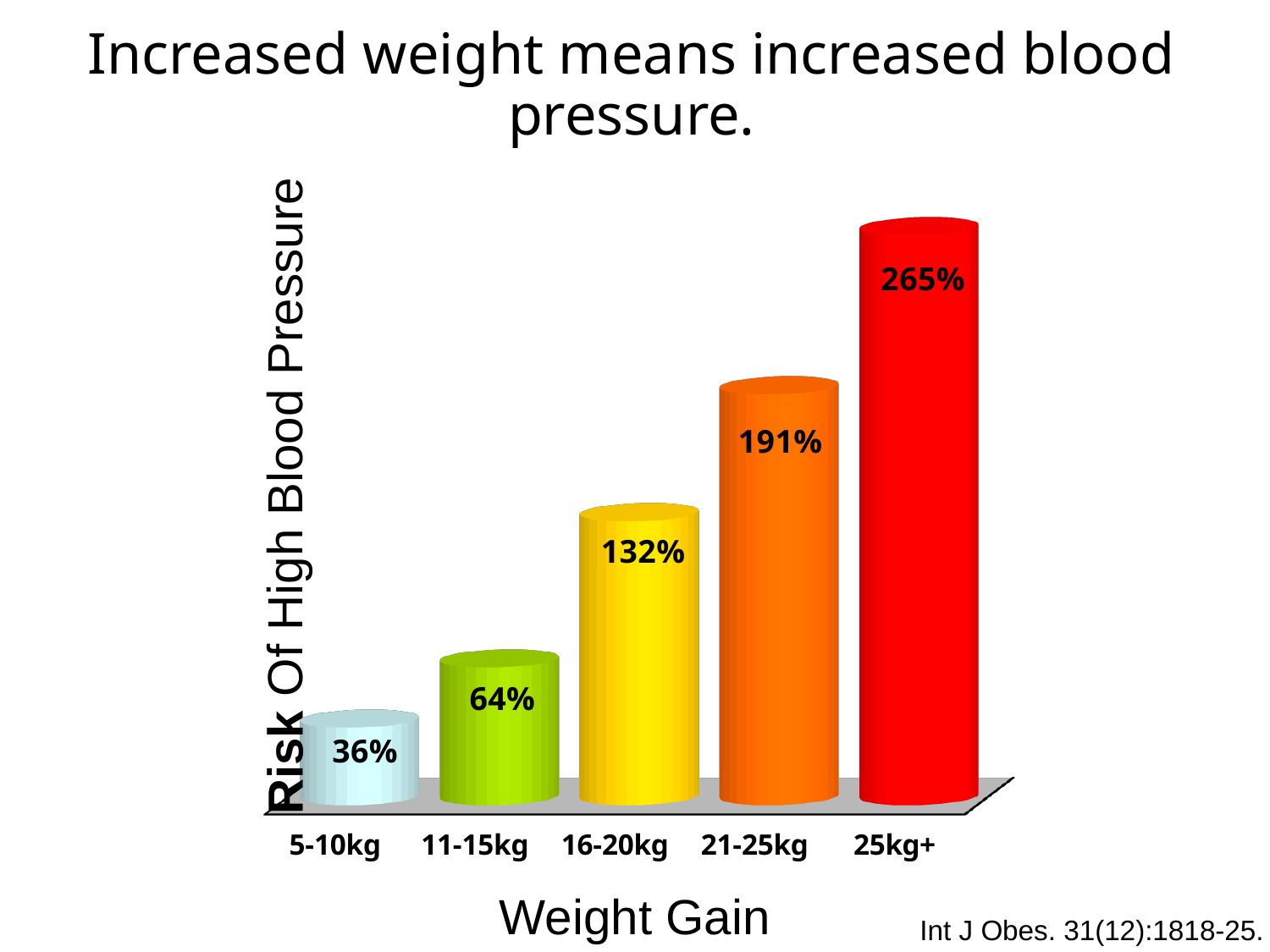
What is the risk of high blood pressure for a weight gain of 16-20kg? 132% What is the difference in risk between the 21-25kg and 11-15kg weight gain categories? 127% What is the risk of high blood pressure for a weight gain of 25kg+? 265% Which has a higher risk of high blood pressure: 11-15kg or 16-20kg weight gain? 16-20kg What kind of chart is shown on the slide? Bar chart What is the difference in risk between the 25kg+ and 21-25kg weight gain categories? 74% Which weight gain category has the highest risk of high blood pressure? 25kg+ Which weight gain category has the lowest risk of high blood pressure? 5-10kg What is the label of the x axis of the chart? Weight Gain What is the risk of high blood pressure for a weight gain of 5-10kg? 36% Do the values rise or fall as weight gain increases along the x axis? Rise How many weight gain categories are shown on the chart? 5